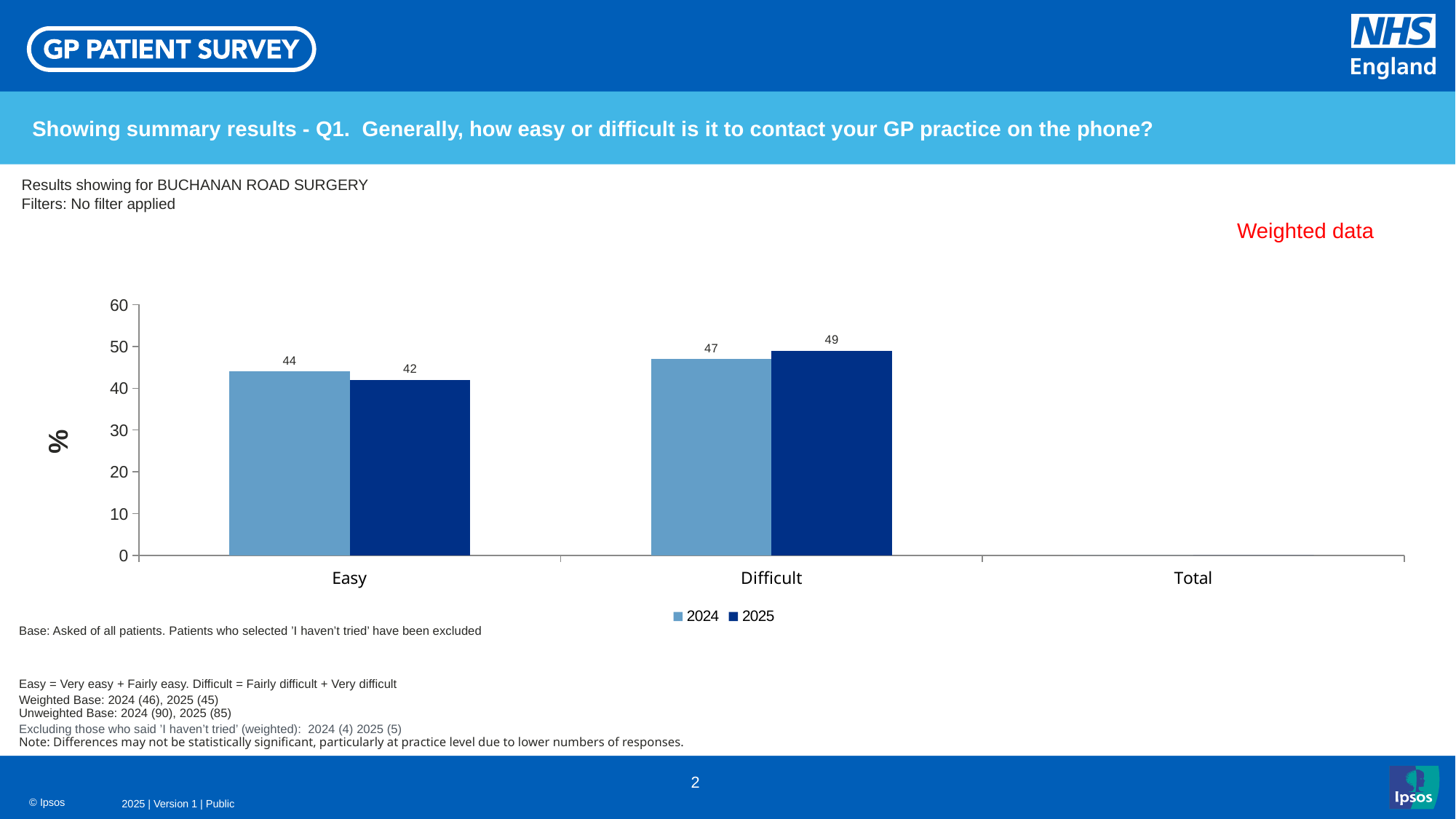
Which is larger, the 2024 value for Difficult or the 2025 value for Difficult? 2025 What is the value for Easy in 2025? 42 What is the value for Easy in 2024? 44 What is the value for Difficult in 2024? 47 What label is shown on the vertical axis of the chart? % What kind of chart is shown on the slide? Bar chart What is the difference between the 2025 values for Difficult and Easy? 7 What is the difference between the 2024 and 2025 values for Easy? 2 How many series does the legend list? 2 Which category has the lowest value for the 2024 series? Easy Which category has the highest value for the 2025 series? Difficult What is the value for Difficult in 2025? 49